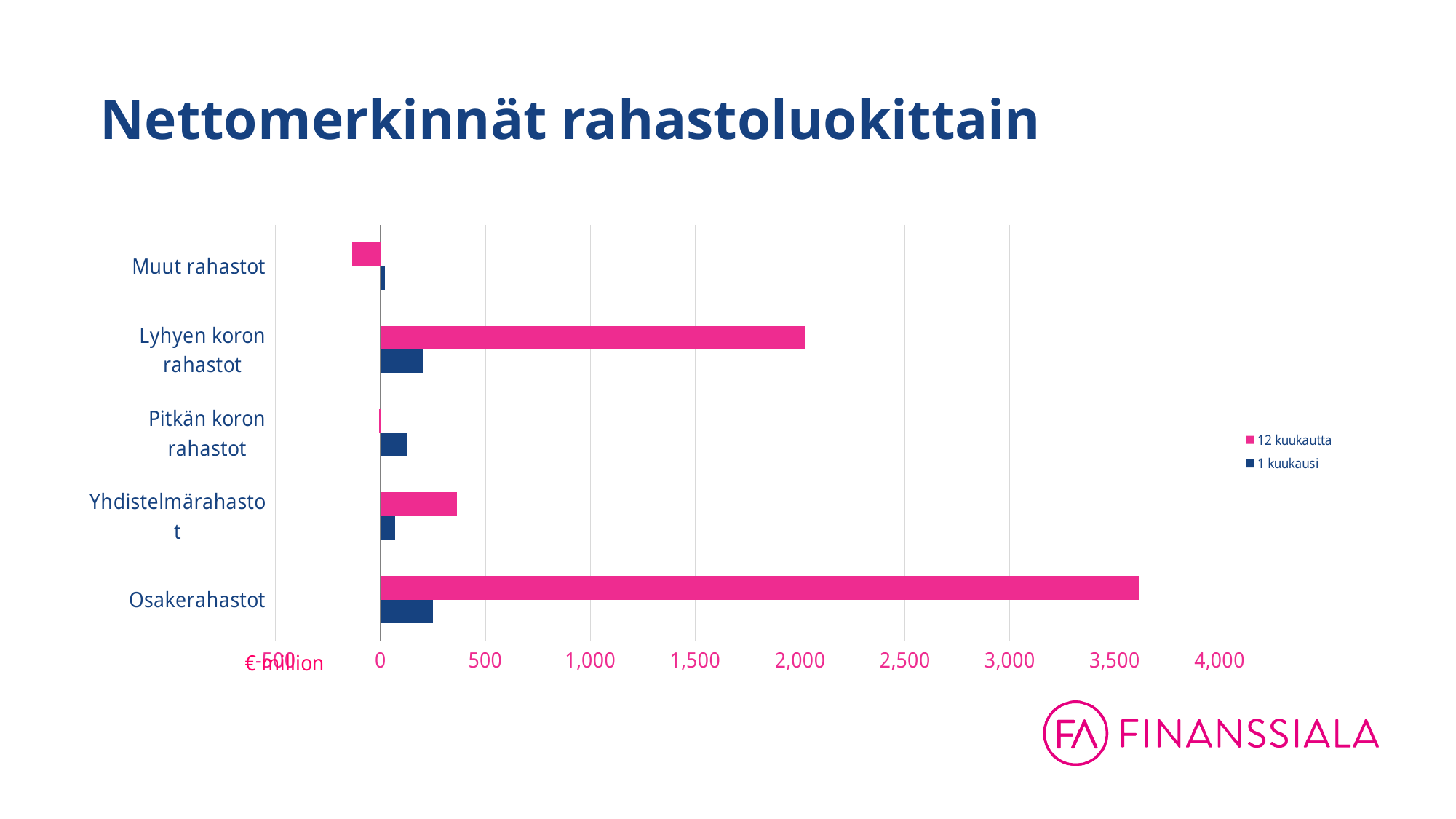
Which category has the highest value for the 12 kuukautta series? Osakerahastot Is the 12 kuukautta value for Yhdistelmärahastot greater or less than 500? less What kind of chart is shown on the slide? bar chart What is the title of the chart? Nettomerkinnät rahastoluokittain Is the 12 kuukautta value for Muut rahastot greater or less than 0? less Which category has the highest value for the 1 kuukausi series? Osakerahastot How many fund categories are shown on the chart? 5 Which category has the lowest value for the 12 kuukautta series? Muut rahastot Is the 12 kuukautta value for Osakerahastot greater or less than 3,500? greater How many series does the legend list? 2 For the 12 kuukautta series, which is larger: Osakerahastot or Lyhyen koron rahastot? Osakerahastot